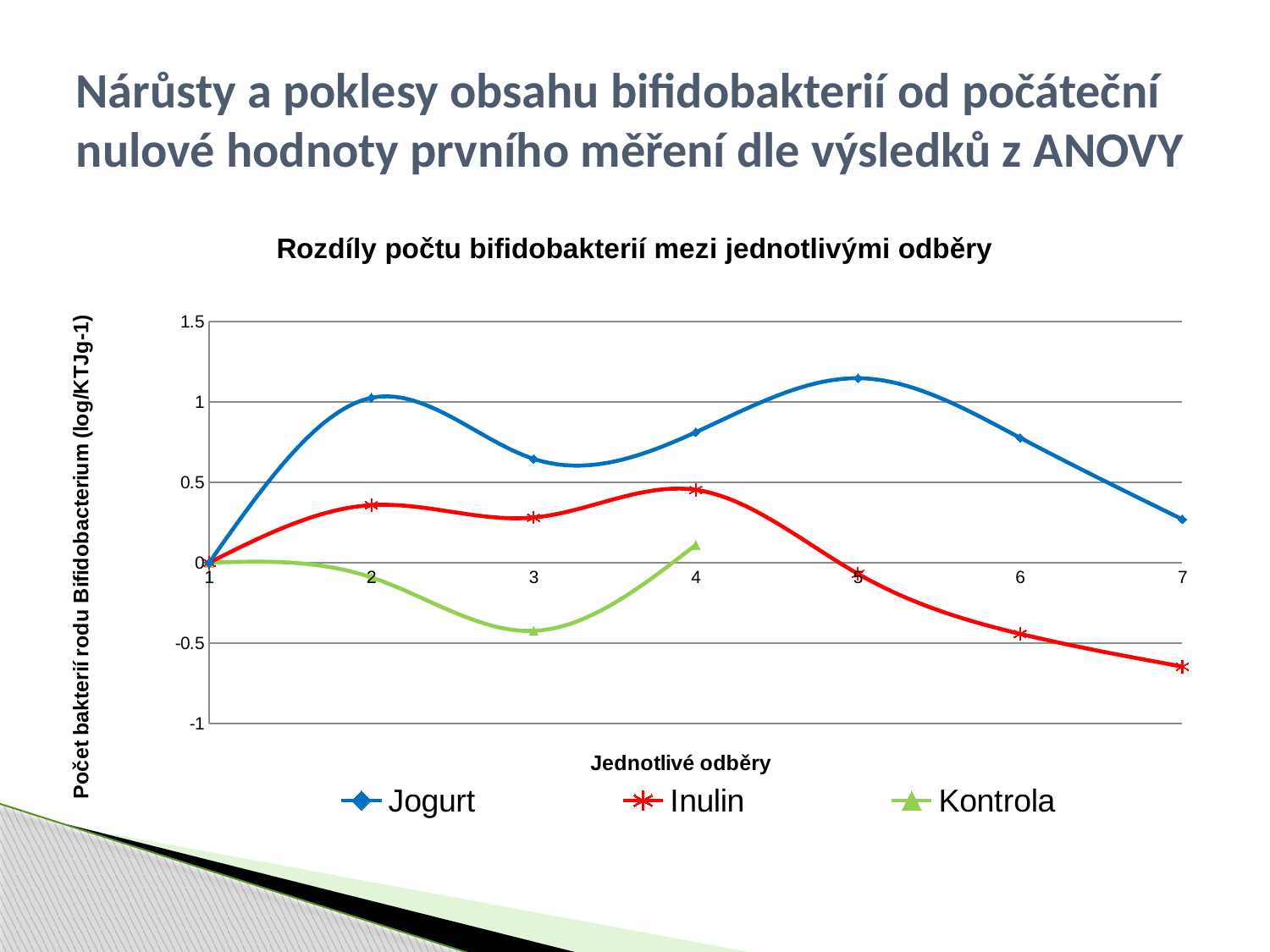
What kind of chart is shown on the slide? line chart How many data points does the Kontrola series have? 4 Is the value for Jogurt at sampling point 5 greater or less than 1? greater At which sampling point does the Kontrola series reach its lowest value? 3 Is the value for Inulin at sampling point 7 greater or less than -0.5? less How many series does the legend list? 3 What is the title of the chart? Rozdíly počtu bifidobakterií mezi jednotlivými odběry How many sampling points (odběry) are shown on the x axis? 7 At which sampling point does the Jogurt series reach its highest value? 5 At sampling point 6, which series has the larger value, Jogurt or Inulin? Jogurt Does the Inulin series rise or fall from sampling point 4 to sampling point 7? fall At which sampling point does the Inulin series reach its lowest value? 7